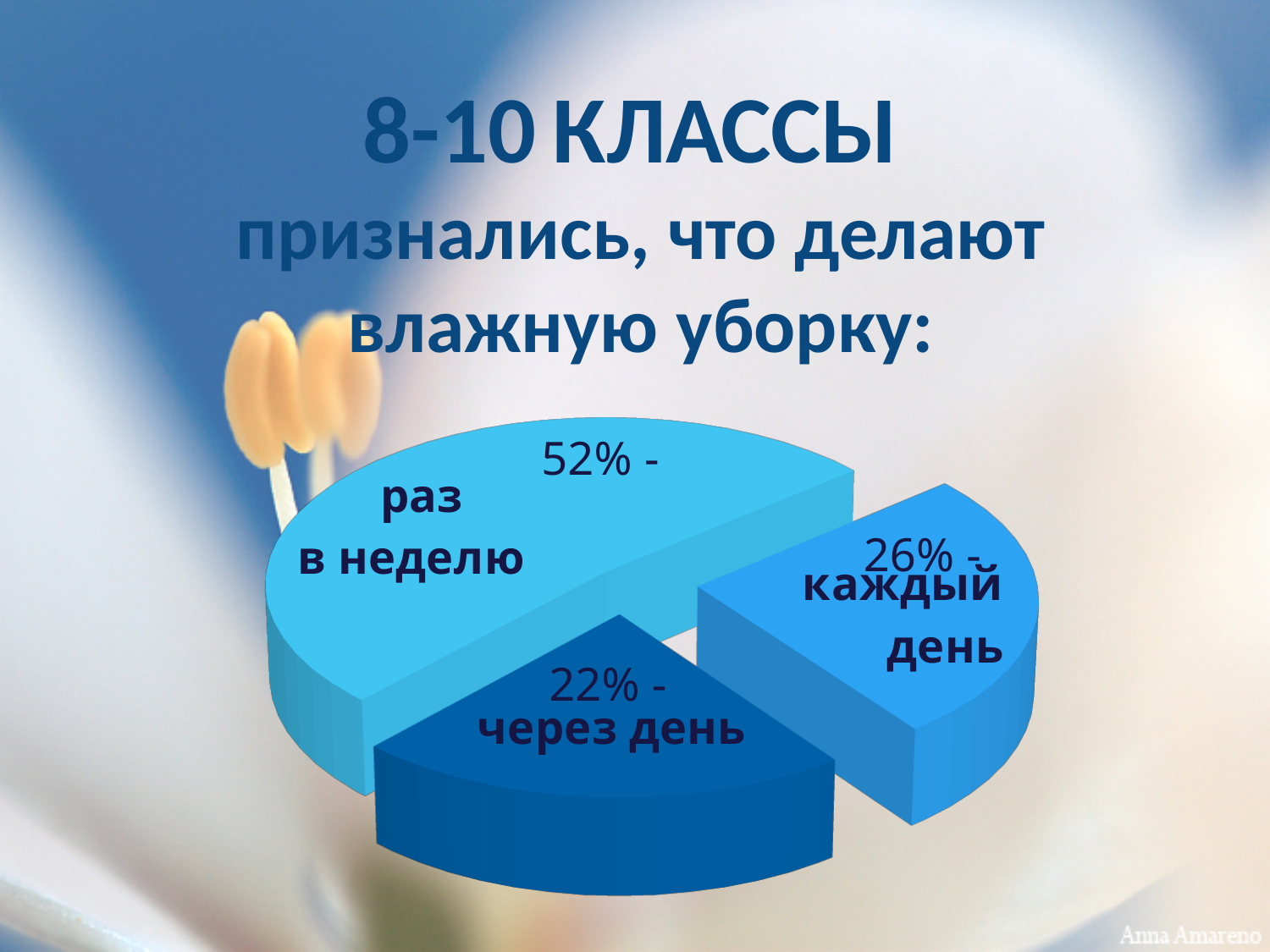
What is the difference in percentage points between the "каждый день" slice and the "через день" slice? 4 What share of the pie is labelled "каждый день"? 26% Which slice of the pie chart is the largest? раз в неделю What share of the pie is labelled "раз в неделю"? 52% Which group of classes does the slide title say the chart is about? 8-10 классы Which is larger: the "каждый день" slice or the "через день" slice? каждый день What is the difference in percentage points between the "раз в неделю" slice and the "каждый день" slice? 26 Is the share for "раз в неделю" greater or less than 50%? greater Which slice of the pie chart is the smallest? через день How many slices does the pie chart have? 3 What kind of chart is shown on the slide? pie chart What share of the pie is labelled "через день"? 22%